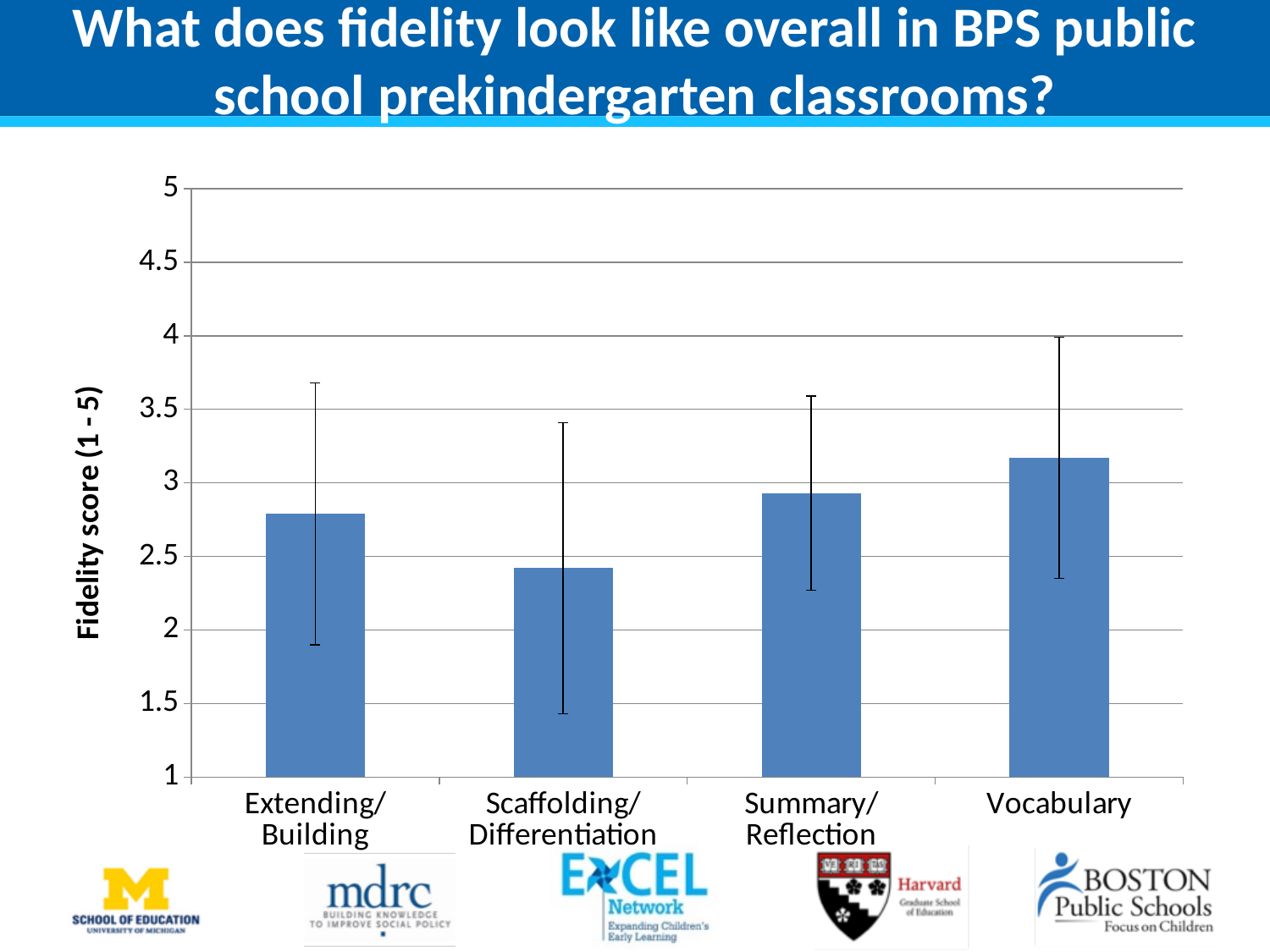
Which category has the highest fidelity score? Vocabulary Which has a higher fidelity score, Vocabulary or Extending/Building? Vocabulary What kind of chart is shown on the slide? bar chart Is the fidelity score for Extending/Building greater or less than 3? less Is the fidelity score for Extending/Building greater or less than 2.5? greater Which category has the lowest fidelity score? Scaffolding/Differentiation Is the fidelity score for Vocabulary greater or less than 3? greater What is the label on the vertical axis of the chart? Fidelity score (1 - 5) Which has a higher fidelity score, Summary/Reflection or Scaffolding/Differentiation? Summary/Reflection How many categories are shown on the x axis of the chart? 4